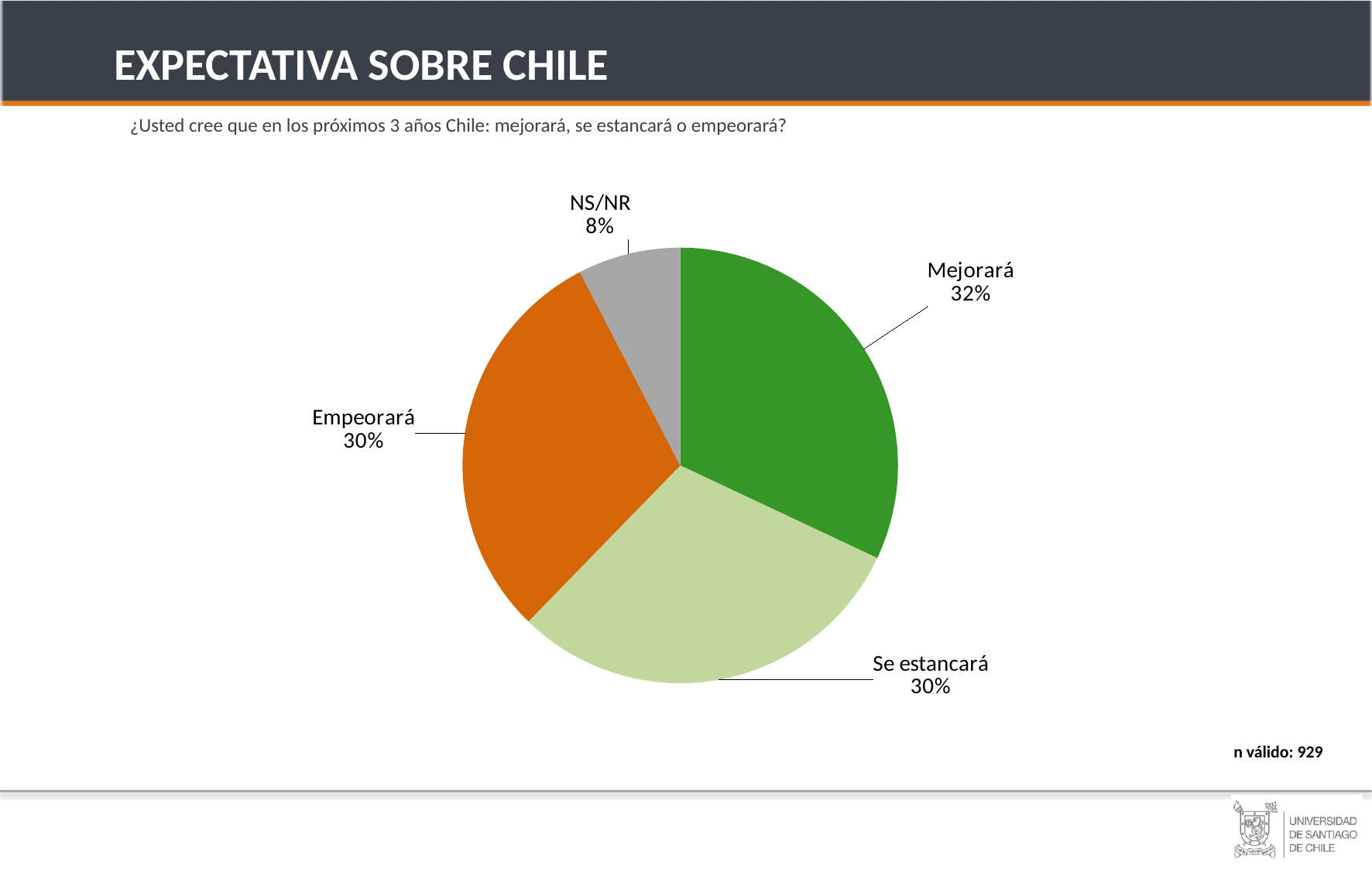
What is the title of the slide? EXPECTATIVA SOBRE CHILE Which category has the smallest slice of the pie? NS/NR What is the value shown for NS/NR? 8% Which category has the largest slice of the pie? Mejorará What is the value shown for Se estancará? 30% How many categories are shown in the pie chart? 4 What is the difference in percentage points between Mejorará and NS/NR? 24 What share of the pie does Mejorará represent? 32% Which is larger, the slice for Mejorará or the slice for NS/NR? Mejorará What kind of chart is shown on the slide? Pie chart What is the value shown for Empeorará? 30% What colour is the slice for Empeorará? Orange